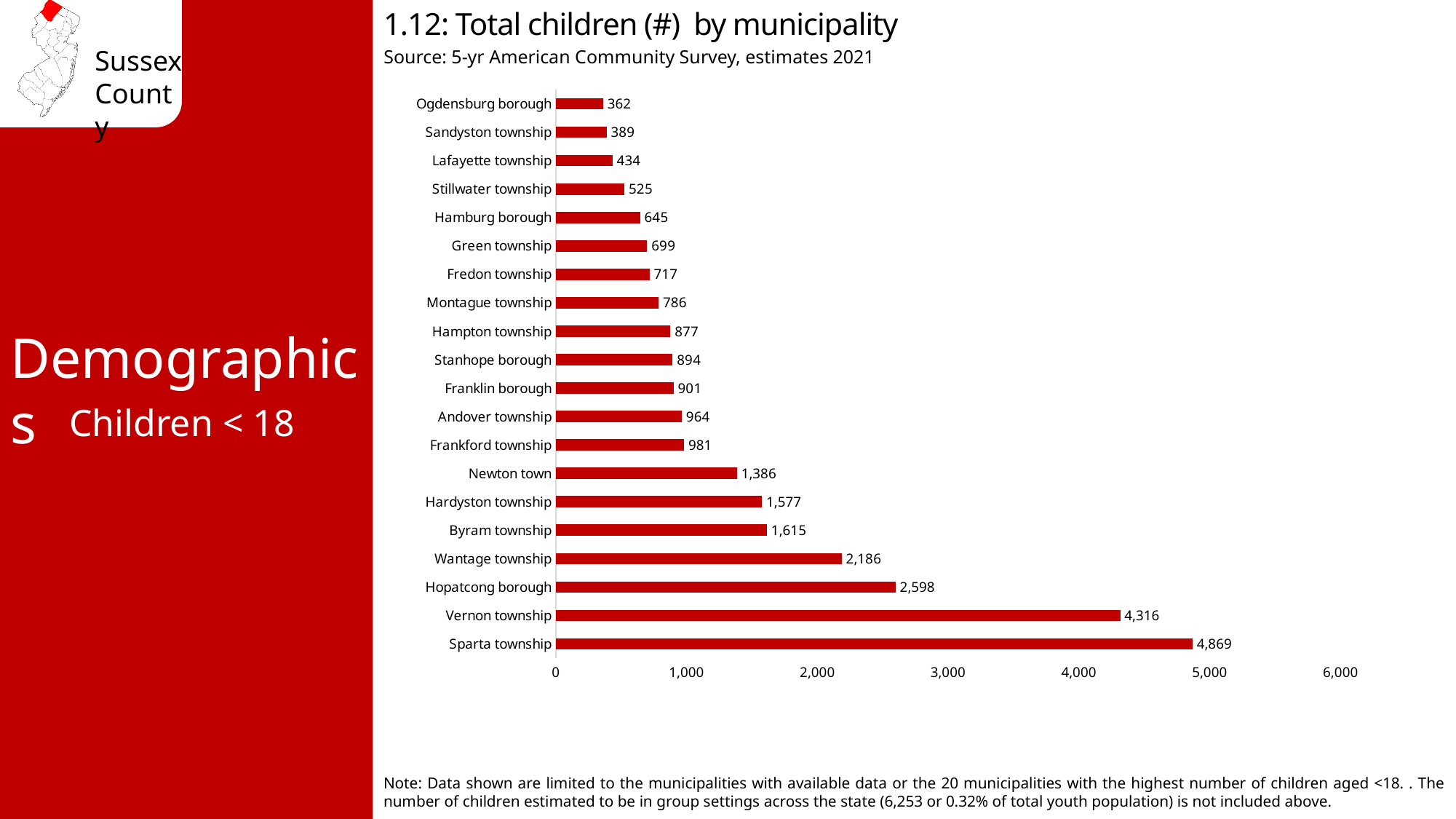
What is the total number of children in Newton town? 1,386 What is the source of the data shown in the chart? 5-yr American Community Survey, estimates 2021 What is the total number of children in Hamburg borough? 645 Is the value for Vernon township greater or less than 4,000? greater What is the difference in the number of children between Hopatcong borough and Wantage township? 412 What is the total number of children in Sparta township? 4,869 Which municipality has the highest number of children? Sparta township Which municipality has the lowest number of children? Ogdensburg borough What is the difference in the number of children between Sparta township and Vernon township? 553 How many municipalities are shown in the chart? 20 Which has more children, Byram township or Hardyston township? Byram township What kind of chart is shown on the slide? bar chart